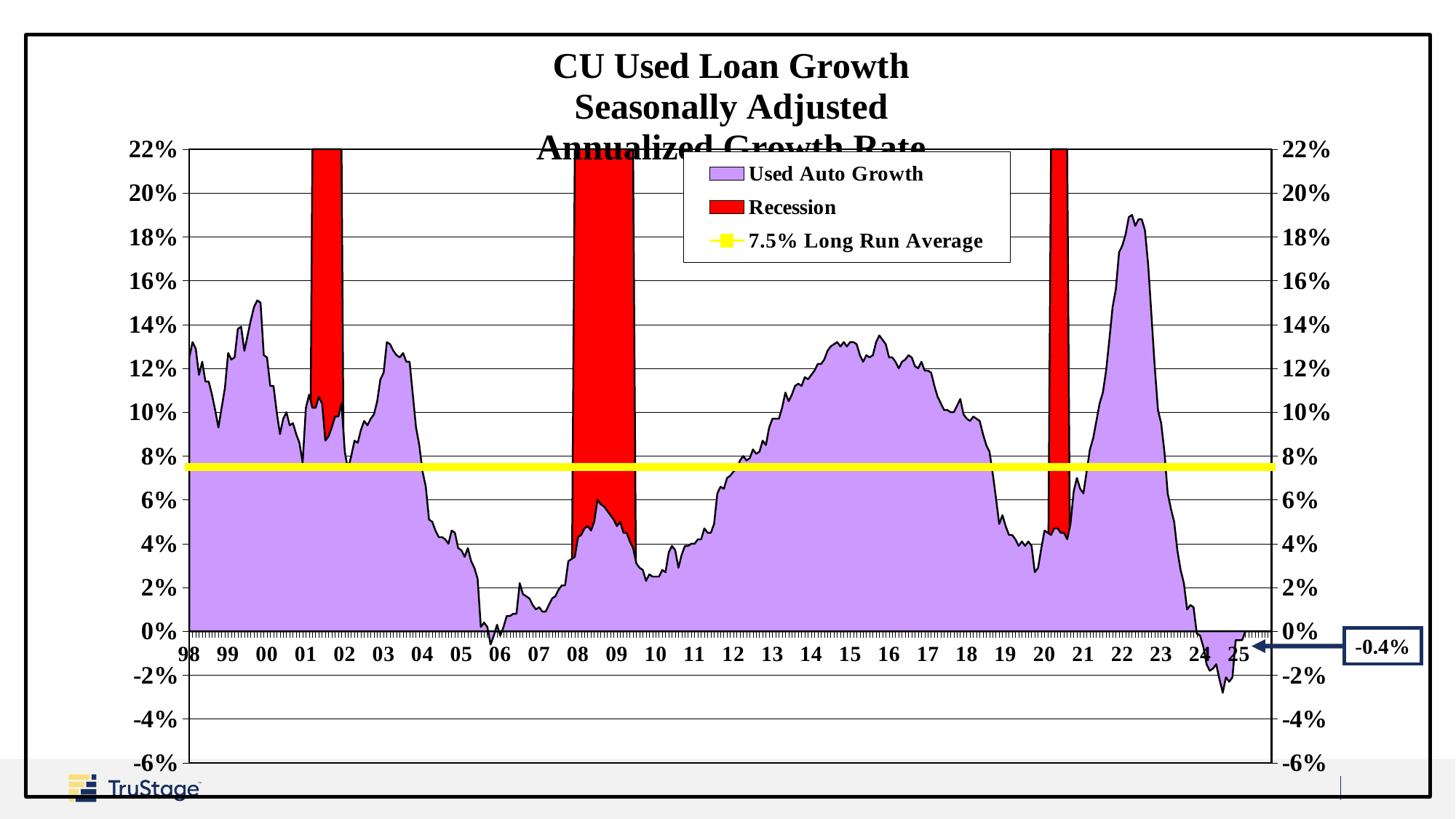
What kind of chart is shown on the slide? Area chart Is the value of Used Auto Growth around 2019 greater or less than 6%? less Is the peak value of Used Auto Growth around 2022 greater or less than 16%? greater What is the most recent value of Used Auto Growth labeled on the chart? -0.4% How many series does the legend list? 3 How many recession periods are shaded on the chart? 3 Is the value of Used Auto Growth around 2015 greater or less than 10%? greater What value does the long run average line represent? 7.5% Do the values of Used Auto Growth rise or fall from the 2022 peak to 2024? fall Which peak is higher: the one around 2000 or the one around 2022? 2022 What colour are the recession periods shaded on the chart? Red